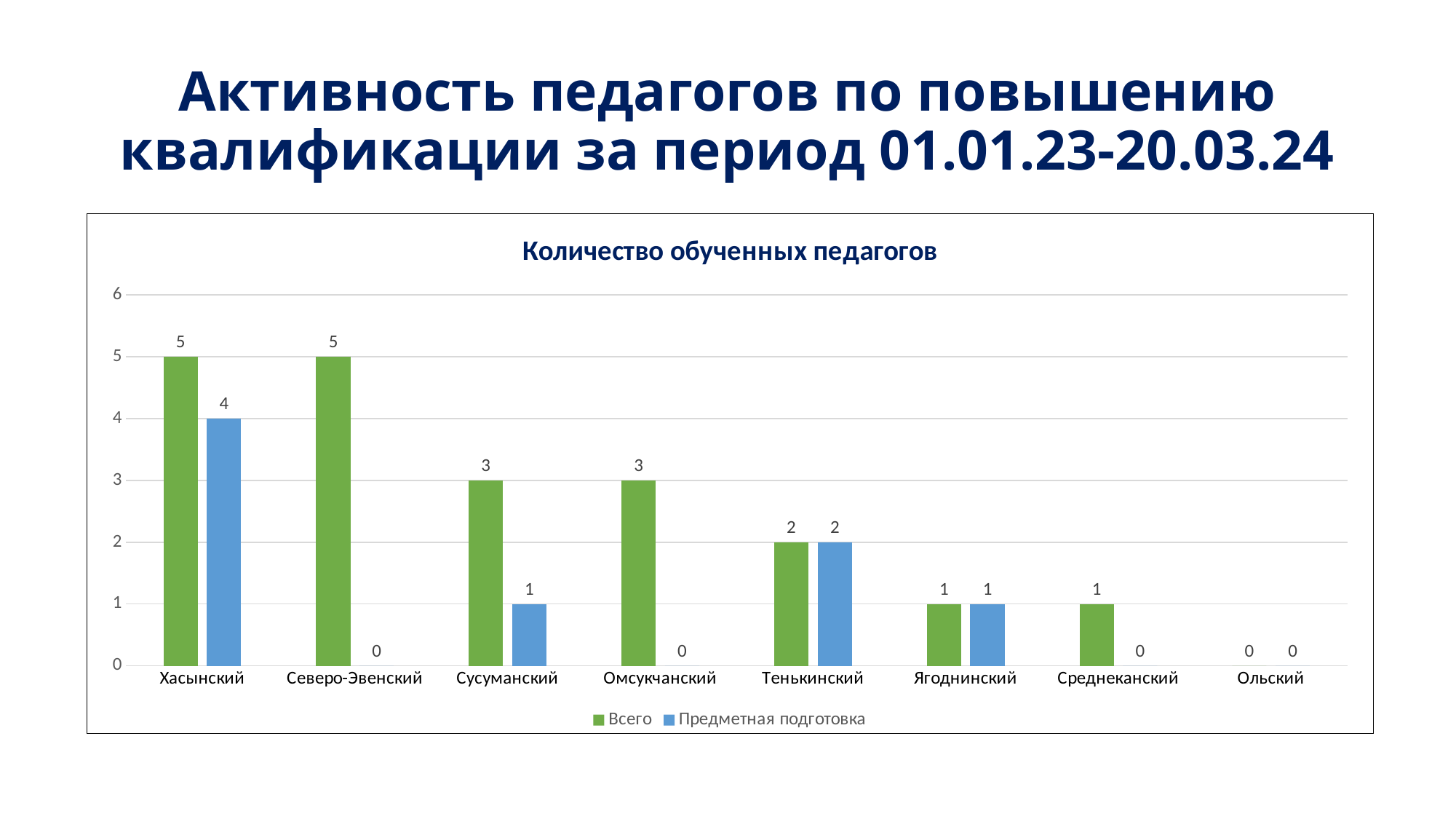
What is the value of 'Предметная подготовка' for Сусуманский? 1 What type of chart is shown? Bar chart Which is larger for Тенькинский: 'Всего' or 'Предметная подготовка'? They are equal (2) What is the value of 'Всего' for Хасынский? 5 How many series does the legend list? 2 How many categories are shown on the x axis? 8 Which category has the highest 'Предметная подготовка' value? Хасынский What is the value of 'Предметная подготовка' for Омсукчанский? 0 Which category has the lowest 'Всего' value? Ольский What is the difference between 'Всего' and 'Предметная подготовка' for Северо-Эвенский? 5 What is the title of the chart? Количество обученных педагогов Is the 'Всего' value for Сусуманский greater or less than 'Всего' for Ягоднинский? greater